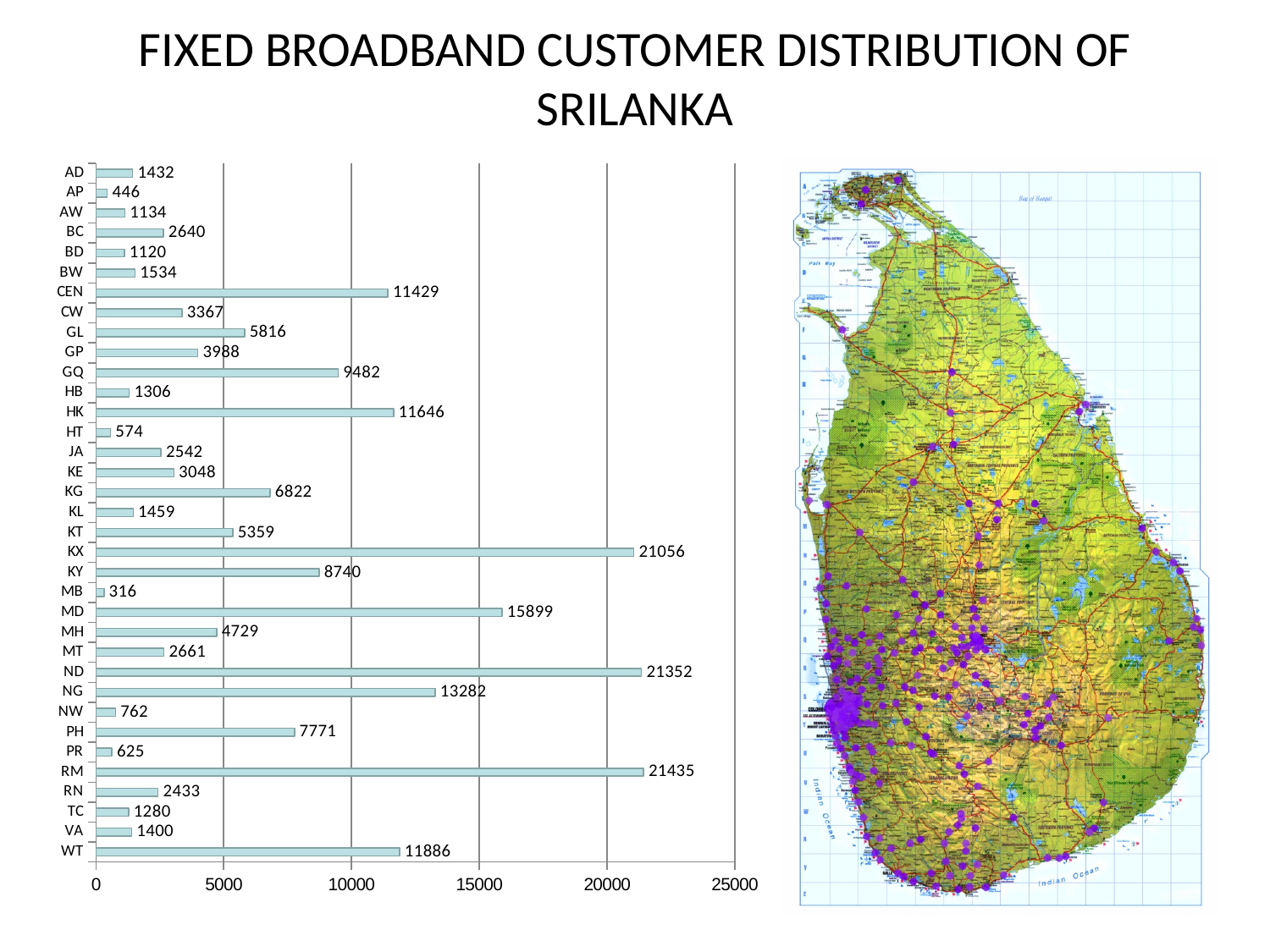
Which is larger, the value for KG or the value for GL? KG What is the difference between the values for ND and KX? 296 What is the value for WT? 11886 What kind of chart is shown on the slide? bar chart What is the value for CEN? 11429 How many categories are shown on the chart? 35 Which category has the lowest value? MB Is the value for MD greater or less than 15000? greater What is the value for KX? 21056 What is the difference between the values for MD and NG? 2617 What is the value for MB? 316 Which is larger, the value for PH or the value for KY? KY